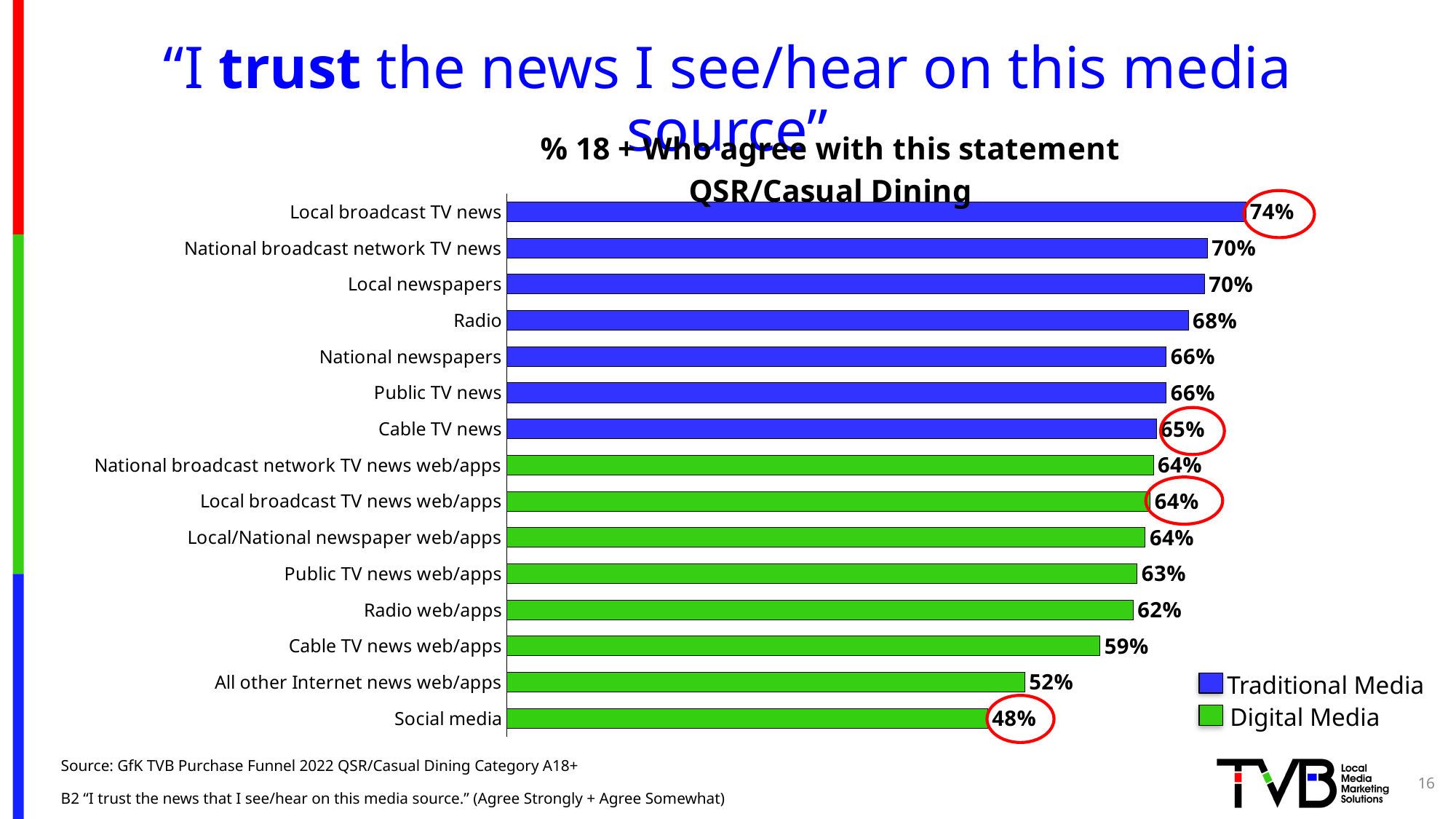
Which media source has the highest percentage of agreement? Local broadcast TV news What is the difference between the values for Local broadcast TV news and Social media? 26 percentage points How many media sources are listed on the chart? 15 What percentage of adults 18+ agree they trust the news on Local broadcast TV news? 74% Which is larger, the value for Cable TV news or the value for Cable TV news web/apps? Cable TV news How many series does the legend list? 2 What is the value shown for Radio? 68% What is the value shown for Social media? 48% What is the value shown for Cable TV news web/apps? 59% Which media source has the lowest percentage of agreement? Social media Which colour represents Digital Media in the legend? Green What kind of chart is shown on the slide? Bar chart